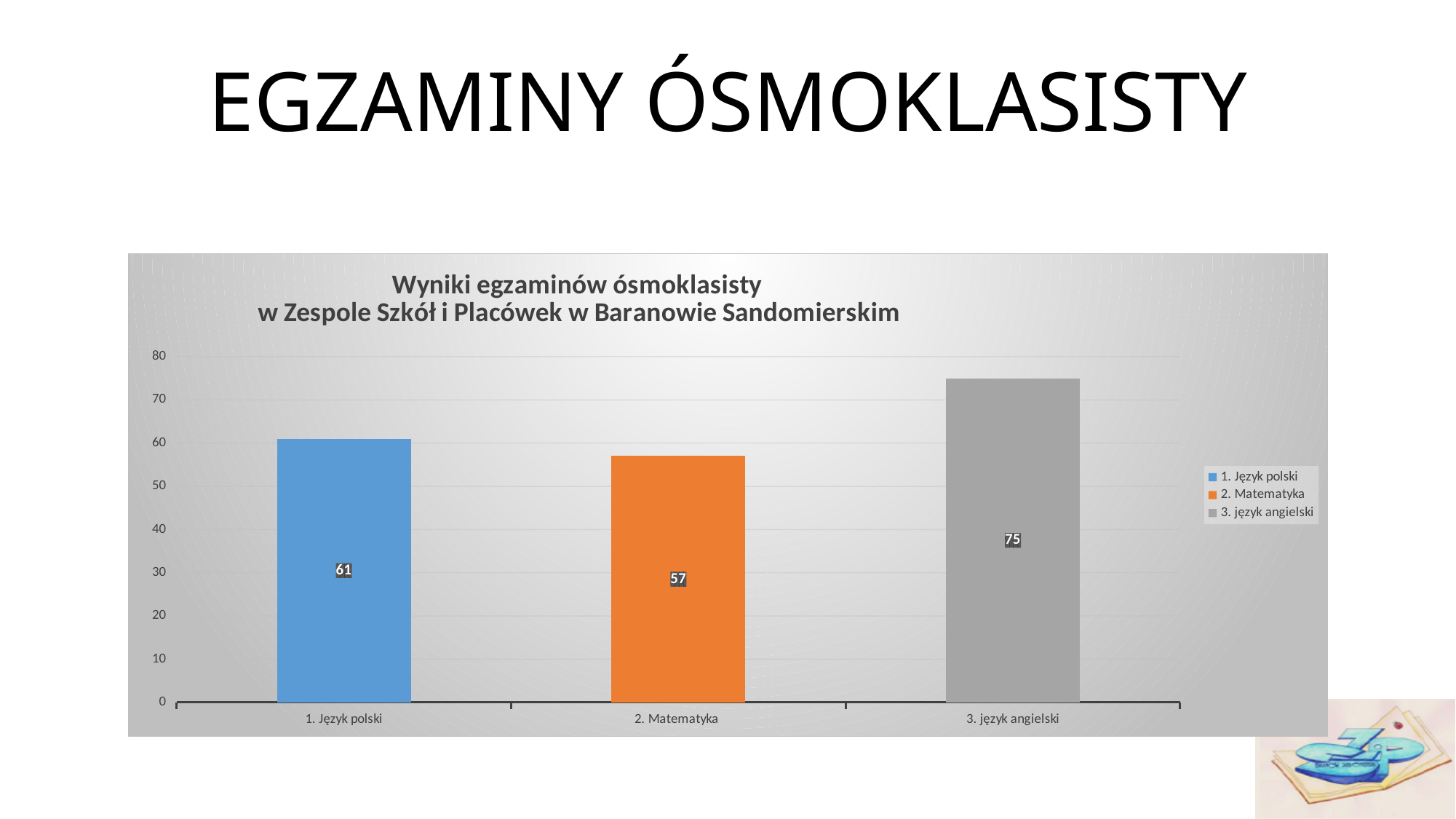
Is the value for 3. język angielski greater or less than 70? greater What is the value for 2. Matematyka? 57 What is the value for 1. Język polski? 61 What is the difference between the values for 3. język angielski and 2. Matematyka? 18 What colour is the bar for 2. Matematyka? orange Which is larger, the value for 1. Język polski or the value for 2. Matematyka? 1. Język polski What is the difference between the values for 1. Język polski and 2. Matematyka? 4 What kind of chart is shown on the slide? bar chart How many categories are shown in the chart? 3 Which category has the highest value? 3. język angielski What is the value for 3. język angielski? 75 Which category has the lowest value? 2. Matematyka